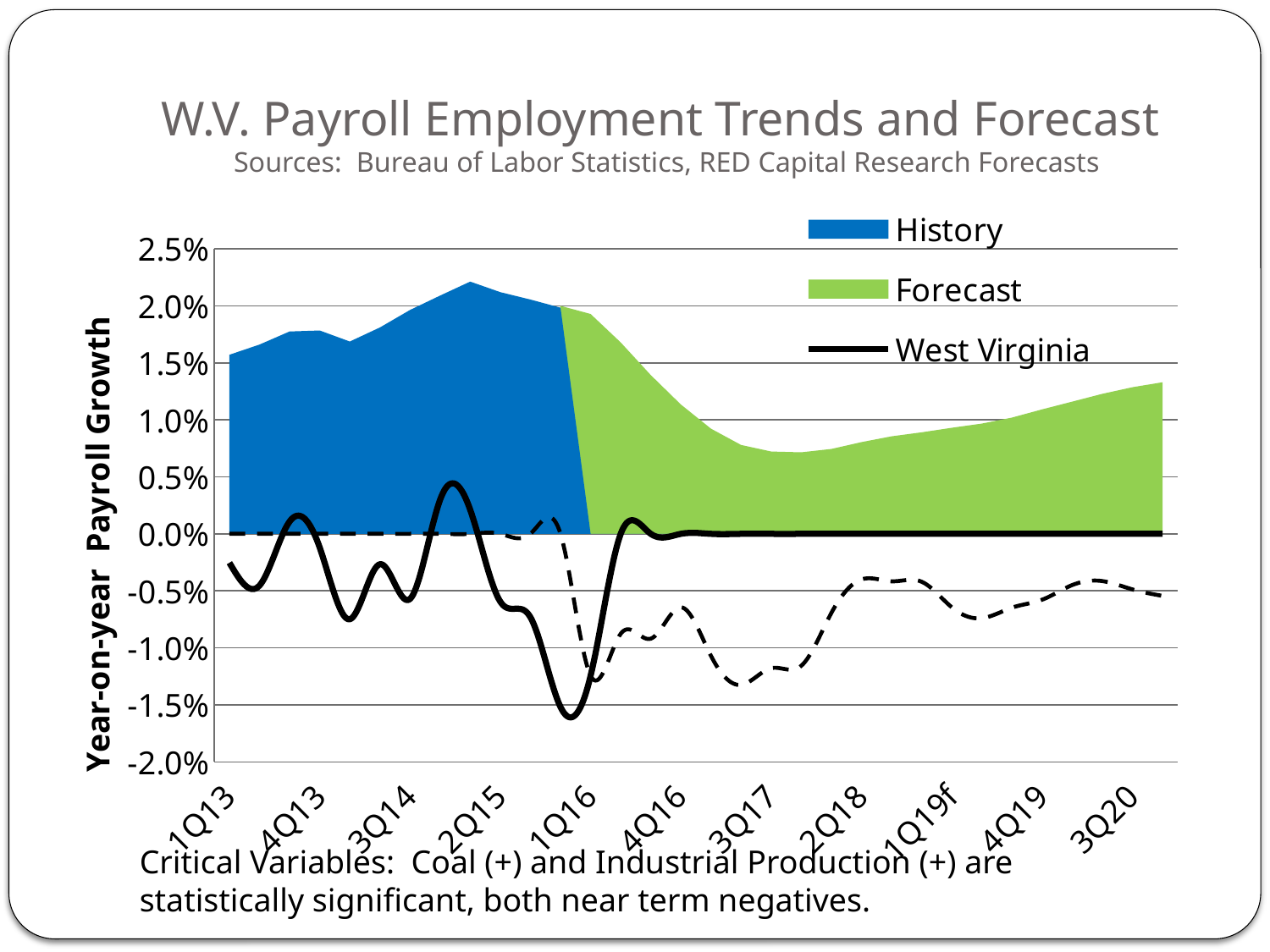
What is the highest value shown on the vertical axis? 2.5% Is the Forecast value at 3Q20 greater or less than 1.0%? greater What is the title of the chart? W.V. Payroll Employment Trends and Forecast Is the Forecast value at 3Q17 greater or less than 1.0%? less Is the West Virginia line's lowest point, near 1Q16, greater or less than -1.0%? less Does the Forecast area rise or fall from 3Q17 to 3Q20? rise How many quarter labels are shown along the x axis? 11 What is the label on the vertical axis? Year-on-year Payroll Growth What kind of chart is this? Combined area and line chart How many series does the legend list? 3